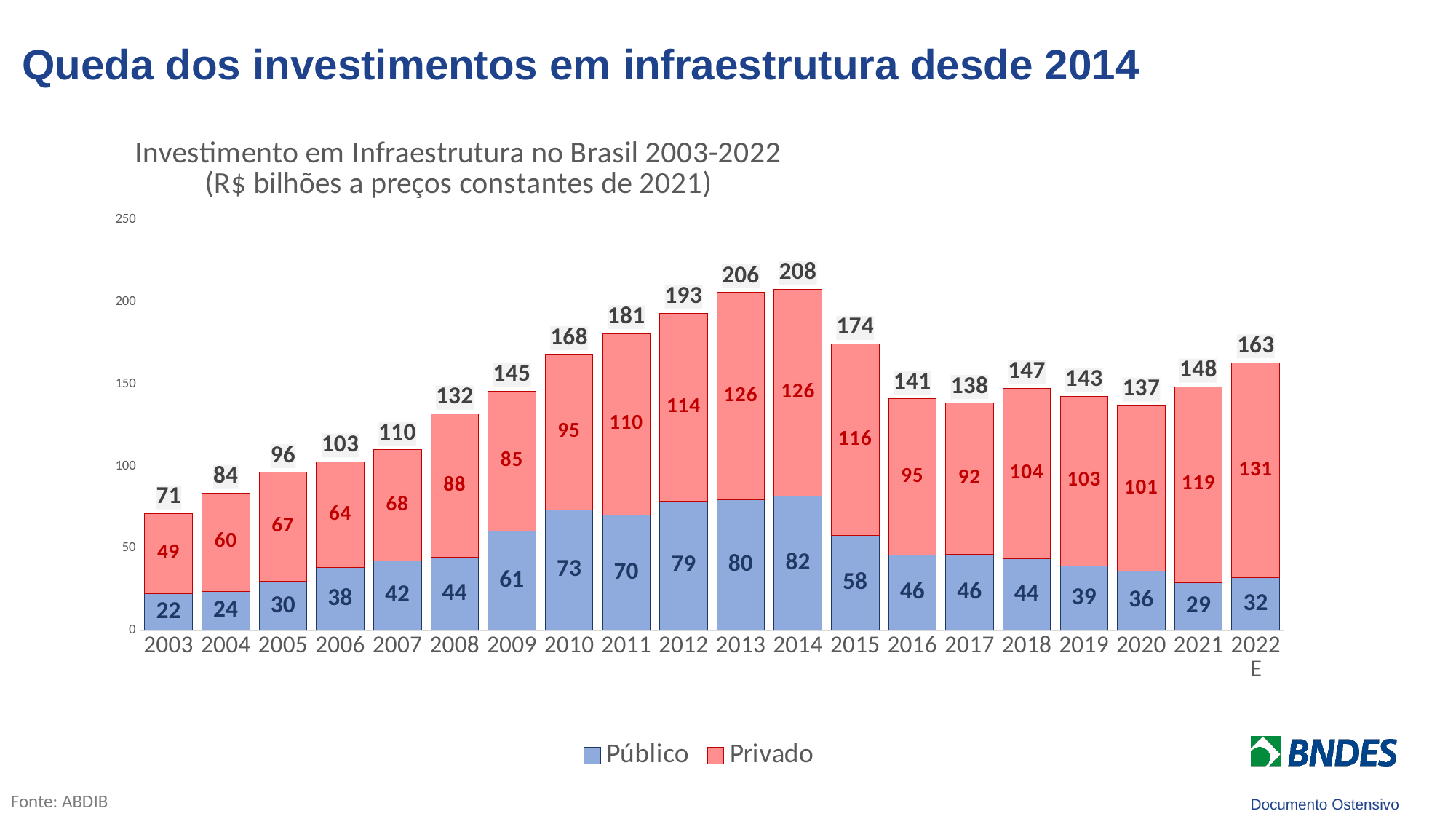
What is the total investment shown for 2009? 145 Which is larger, the Público value for 2013 or the Público value for 2015? 2013 How many years are shown on the x axis? 20 Which year has the lowest total investment? 2003 What is the difference between the total for 2014 and the total for 2022 E? 45 What is the Privado value for 2022 E? 131 What is the Público value for 2014? 82 What kind of chart is shown on the slide? Stacked bar chart How many series does the legend list? 2 Which year has the highest total investment? 2014 Which colour represents the Privado series? Red Do the total values rise or fall from 2014 to 2020? Fall